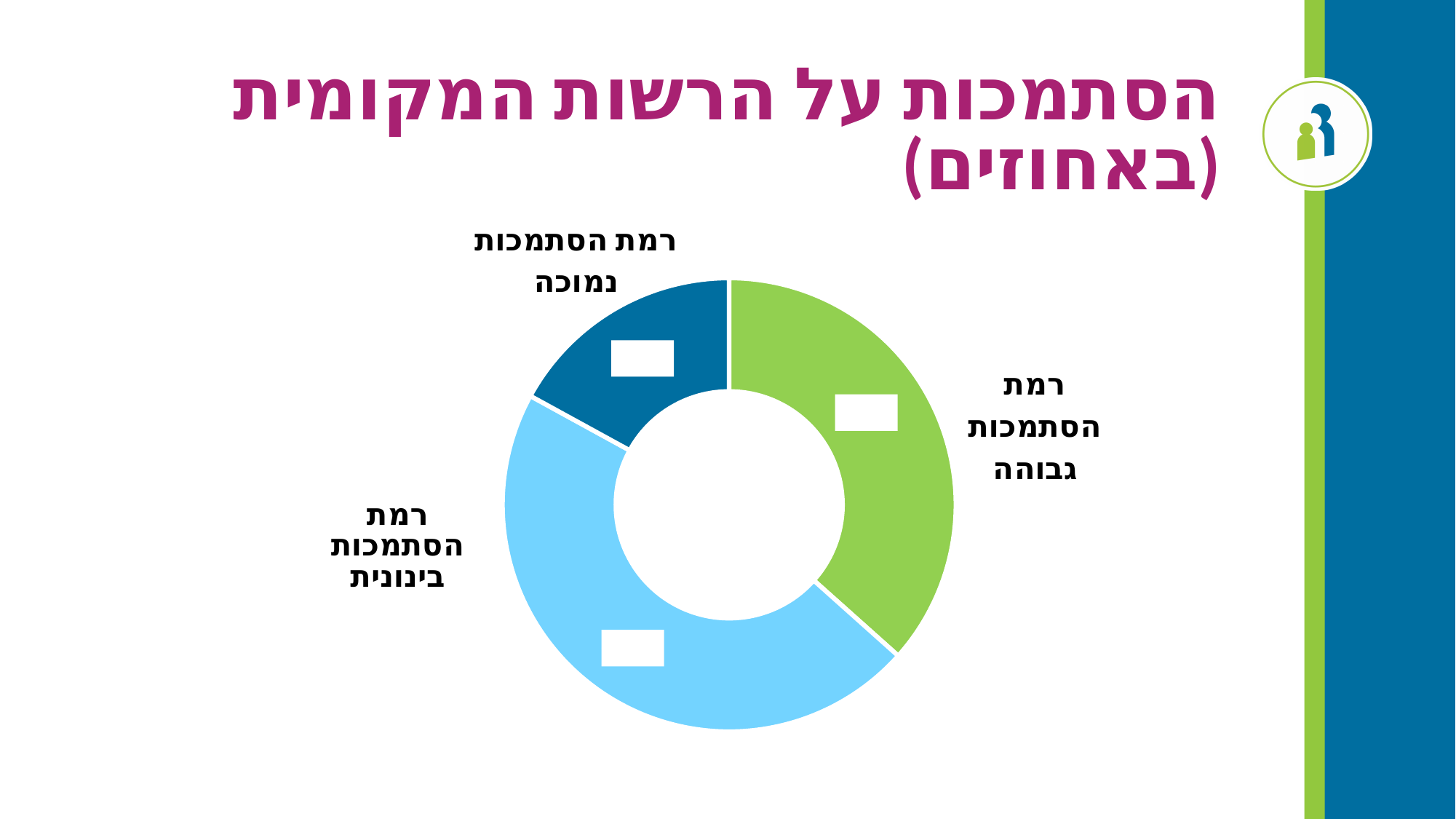
What is the title of the slide's chart? הסתמכות על הרשות המקומית (באחוזים) What colour is the slice for רמת הסתמכות גבוהה? Green What kind of chart is shown on the slide? Donut (pie) chart Which slice is larger: רמת הסתמכות בינונית or רמת הסתמכות נמוכה? רמת הסתמכות בינונית Which category has the largest slice in the chart? רמת הסתמכות בינונית Which category has the smallest slice in the chart? רמת הסתמכות נמוכה Which slice is larger: רמת הסתמכות גבוהה or רמת הסתמכות נמוכה? רמת הסתמכות גבוהה How many categories (slices) does the chart have? 3